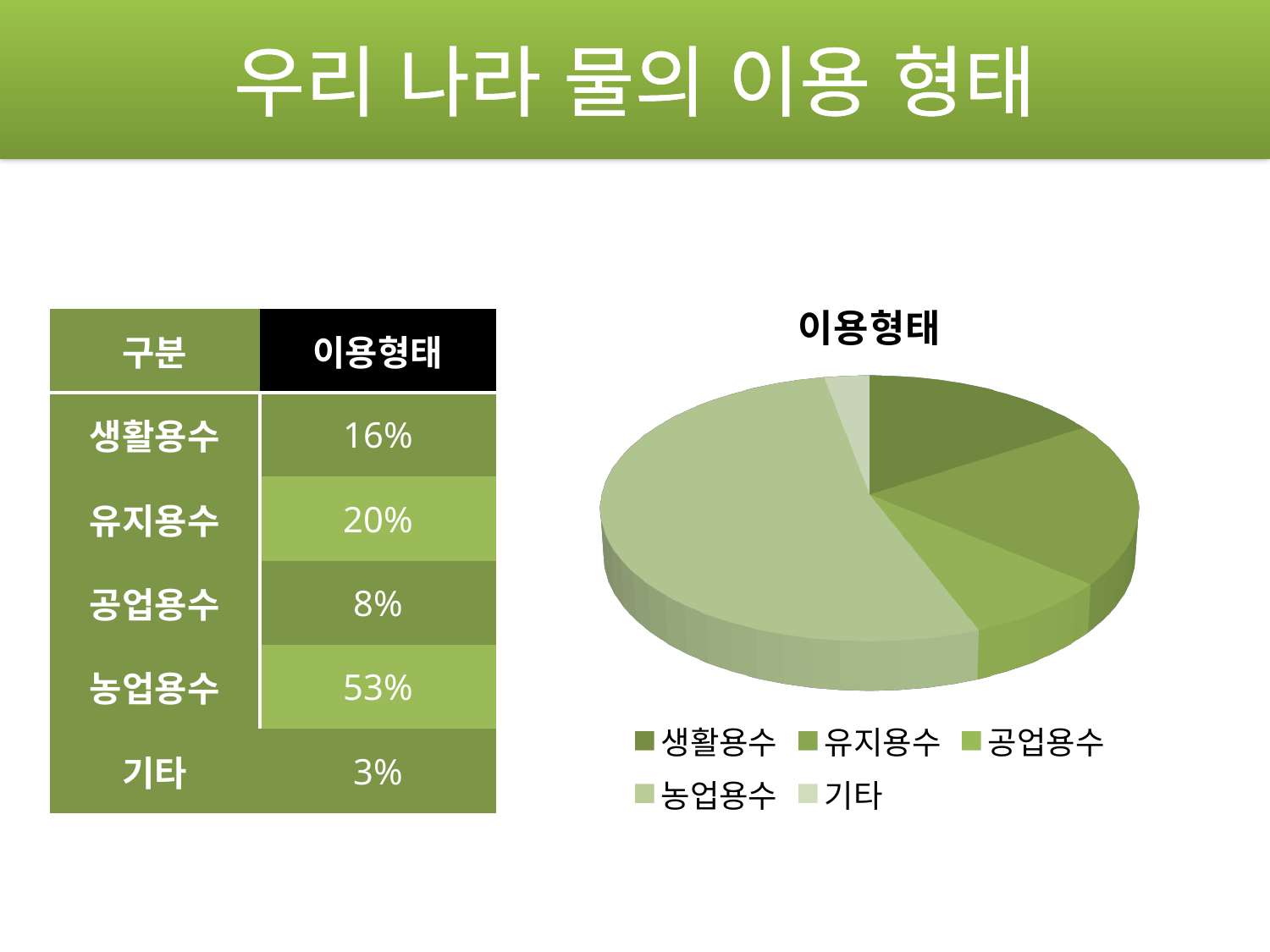
Which is larger, the slice for 유지용수 or the slice for 생활용수? 유지용수 Which category has the largest slice of the pie chart? 농업용수 What share of the pie does 농업용수 represent? 53% What is the title of the chart? 이용형태 What is the difference between the values for 농업용수 and 유지용수? 33% What kind of chart is shown on the slide? pie chart What is the value for 공업용수? 8% What is the value for 생활용수? 16% Which category has the smallest slice of the pie chart? 기타 How many slices does the pie chart have? 5 How many categories does the legend of the pie chart list? 5 What is the value for 유지용수? 20%